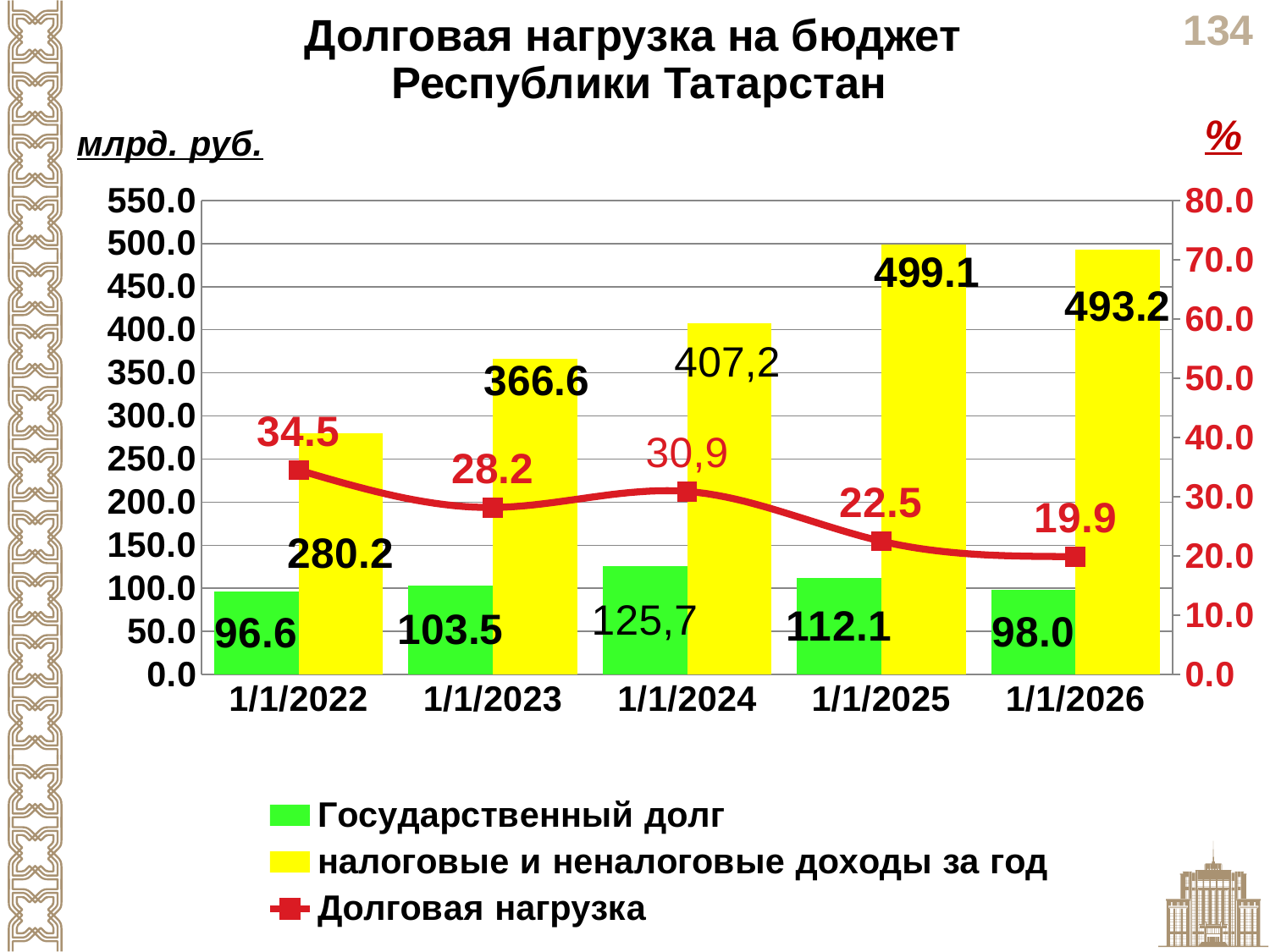
Does Долговая нагрузка rise or fall overall from 1/1/2022 to 1/1/2026? Fall What is the value of Государственный долг for 1/1/2024? 125,7 What colour are the bars for налоговые и неналоговые доходы за год? Yellow What is the Долговая нагрузка value for 1/1/2026? 19.9 How many dates are shown on the x axis? 5 In which year is Долговая нагрузка highest? 1/1/2022 Which is larger: Государственный долг for 1/1/2023 or for 1/1/2025? 1/1/2025 In which year is Государственный долг lowest? 1/1/2022 What kind of chart is this? Combined bar and line chart How many series does the legend list? 3 What is the value of налоговые и неналоговые доходы за год for 1/1/2025? 499.1 What is the difference between налоговые и неналоговые доходы за год for 1/1/2025 and 1/1/2026? 5.9